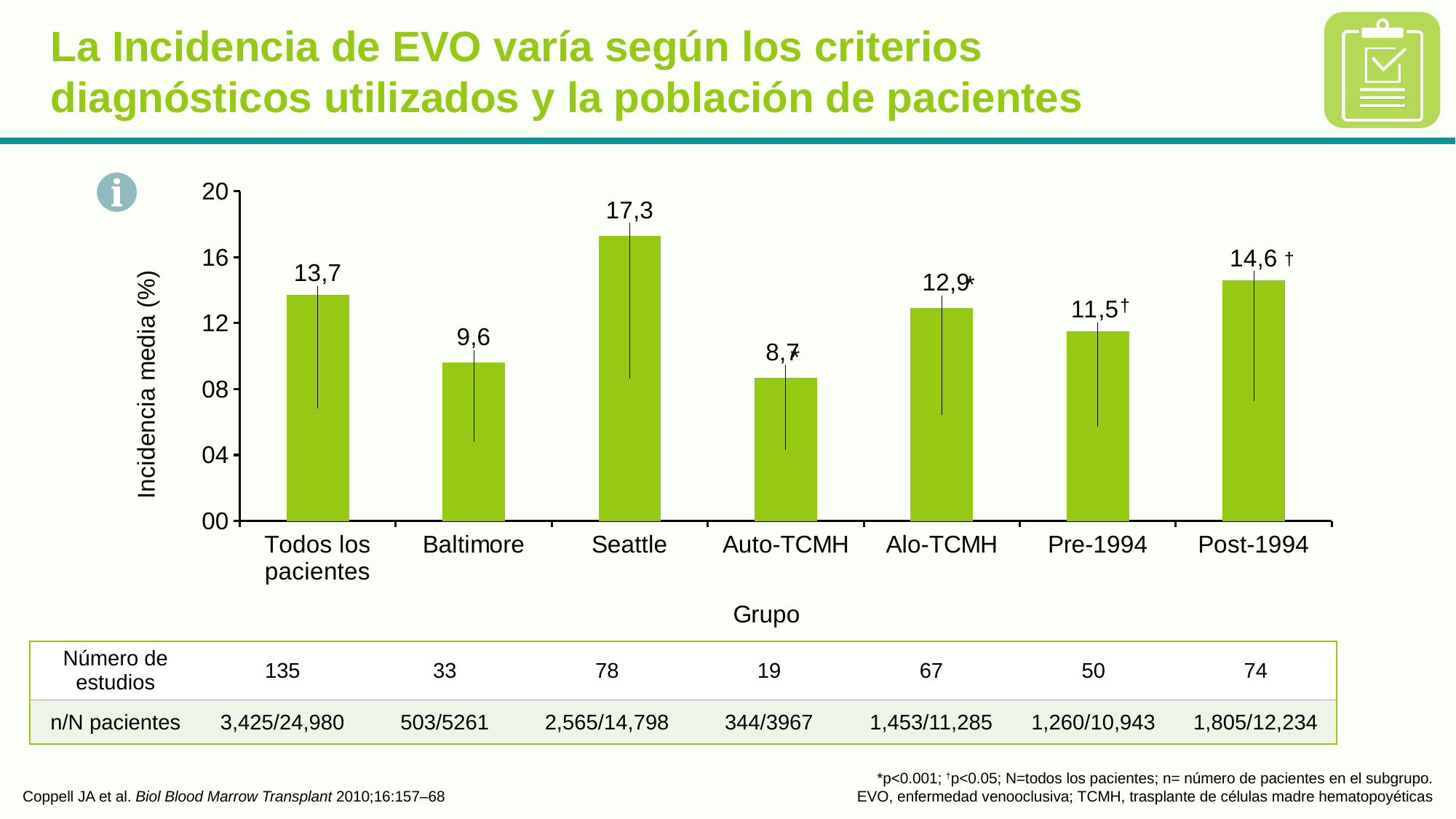
What is the mean incidence (%) for the Baltimore group? 9,6 What is the mean incidence (%) for the Auto-TCMH group? 8,7 What is the mean incidence (%) for the Seattle group? 17,3 What is the difference in mean incidence between Seattle and Baltimore? 7,7 What is the mean incidence (%) for Todos los pacientes? 13,7 What is the difference in mean incidence between Post-1994 and Pre-1994? 3,1 Which group has the highest mean incidence? Seattle How many groups are shown on the x axis of the chart? 7 What is the label of the y axis of the chart? Incidencia media (%) What kind of chart is shown on the slide? Bar chart Which has a higher mean incidence, Alo-TCMH or Auto-TCMH? Alo-TCMH Which group has the lowest mean incidence? Auto-TCMH